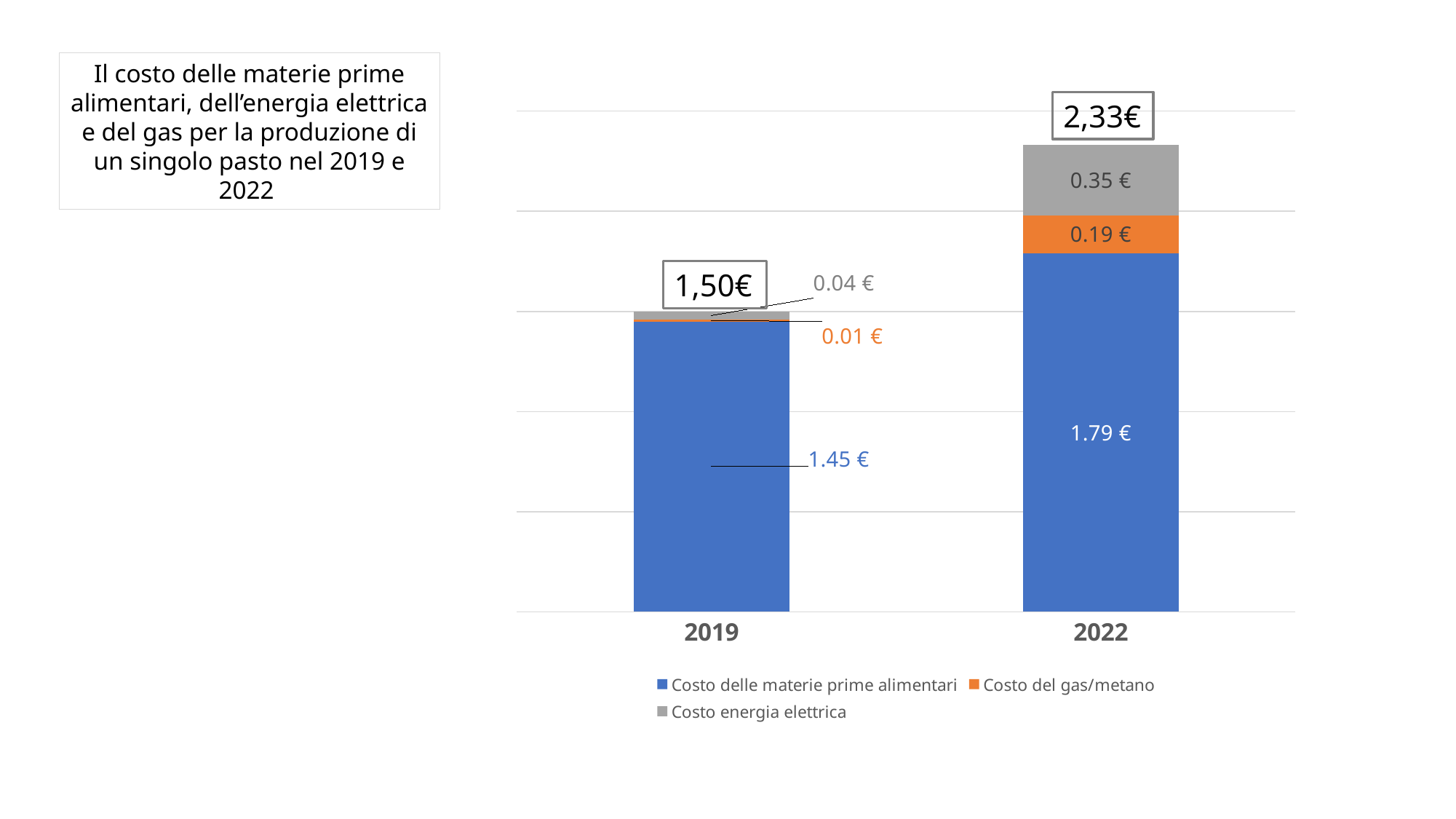
What is the value of Costo delle materie prime alimentari for 2022? 1.79 € What is the difference in Costo delle materie prime alimentari between 2022 and 2019? 0.34 € What is the value of Costo energia elettrica for 2022? 0.35 € What is the value of Costo del gas/metano for 2022? 0.19 € What is the total cost shown for the 2022 bar? 2,33€ How many categories are shown on the x axis? 2 What is the total cost shown for the 2019 bar? 1,50€ What is the value of Costo energia elettrica for 2019? 0.04 € What kind of chart is shown on the slide? Stacked bar chart How many series does the legend list? 3 What is the value of Costo delle materie prime alimentari for 2019? 1.45 € Which year has the larger value for Costo energia elettrica, 2019 or 2022? 2022